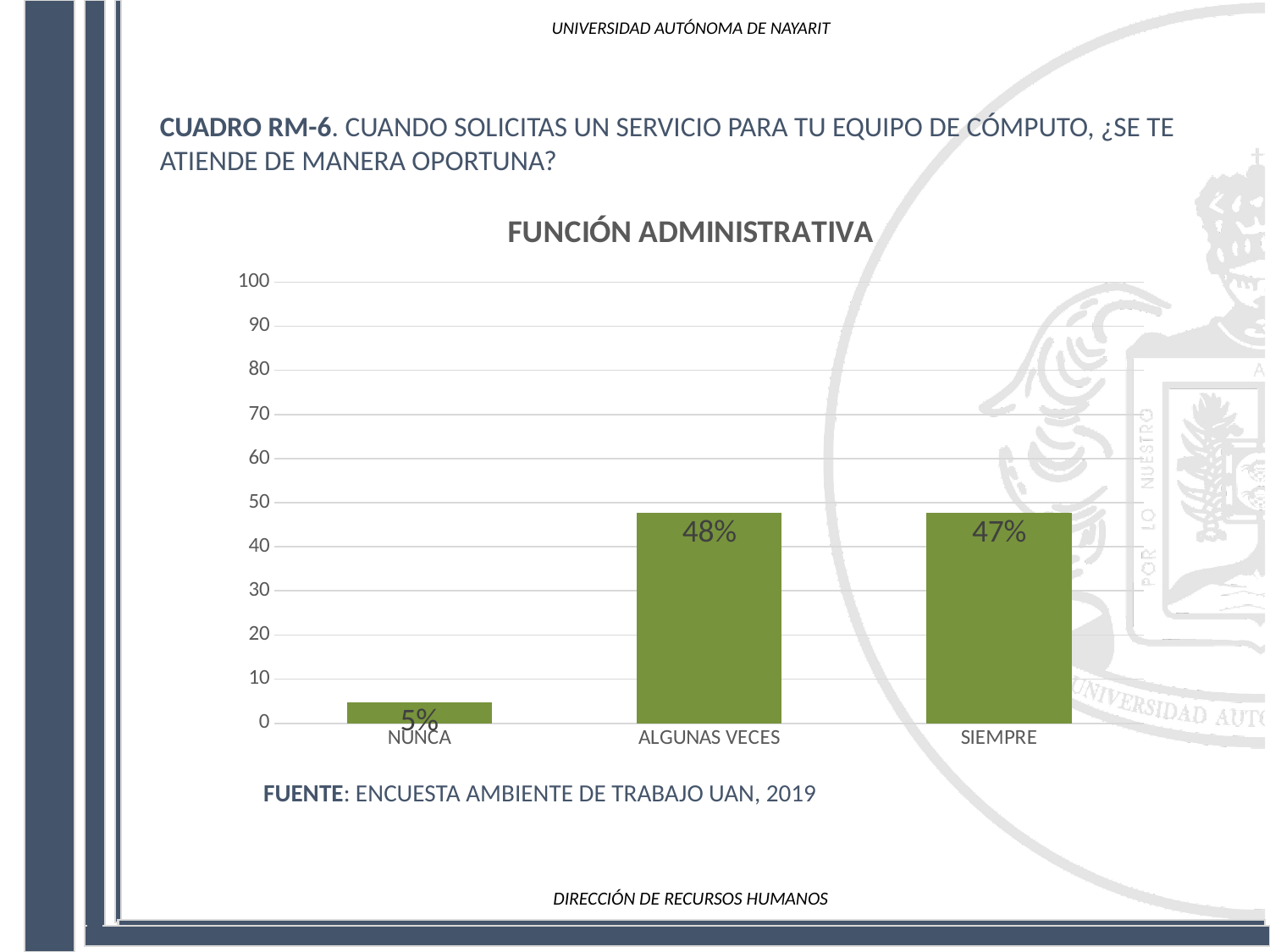
Which is larger, the value for ALGUNAS VECES or the value for NUNCA? ALGUNAS VECES What kind of chart is shown? bar chart Is the value for SIEMPRE greater or less than 30? greater What is the difference between the values for SIEMPRE and NUNCA? 42% What is the difference between the values for ALGUNAS VECES and NUNCA? 43% What is the value for ALGUNAS VECES? 48% What is the value for SIEMPRE? 47% How many categories are shown on the x axis? 3 Which category has the lowest value? NUNCA Is the value for NUNCA greater or less than 10? less What is the title of the chart? FUNCIÓN ADMINISTRATIVA What is the value for NUNCA? 5%